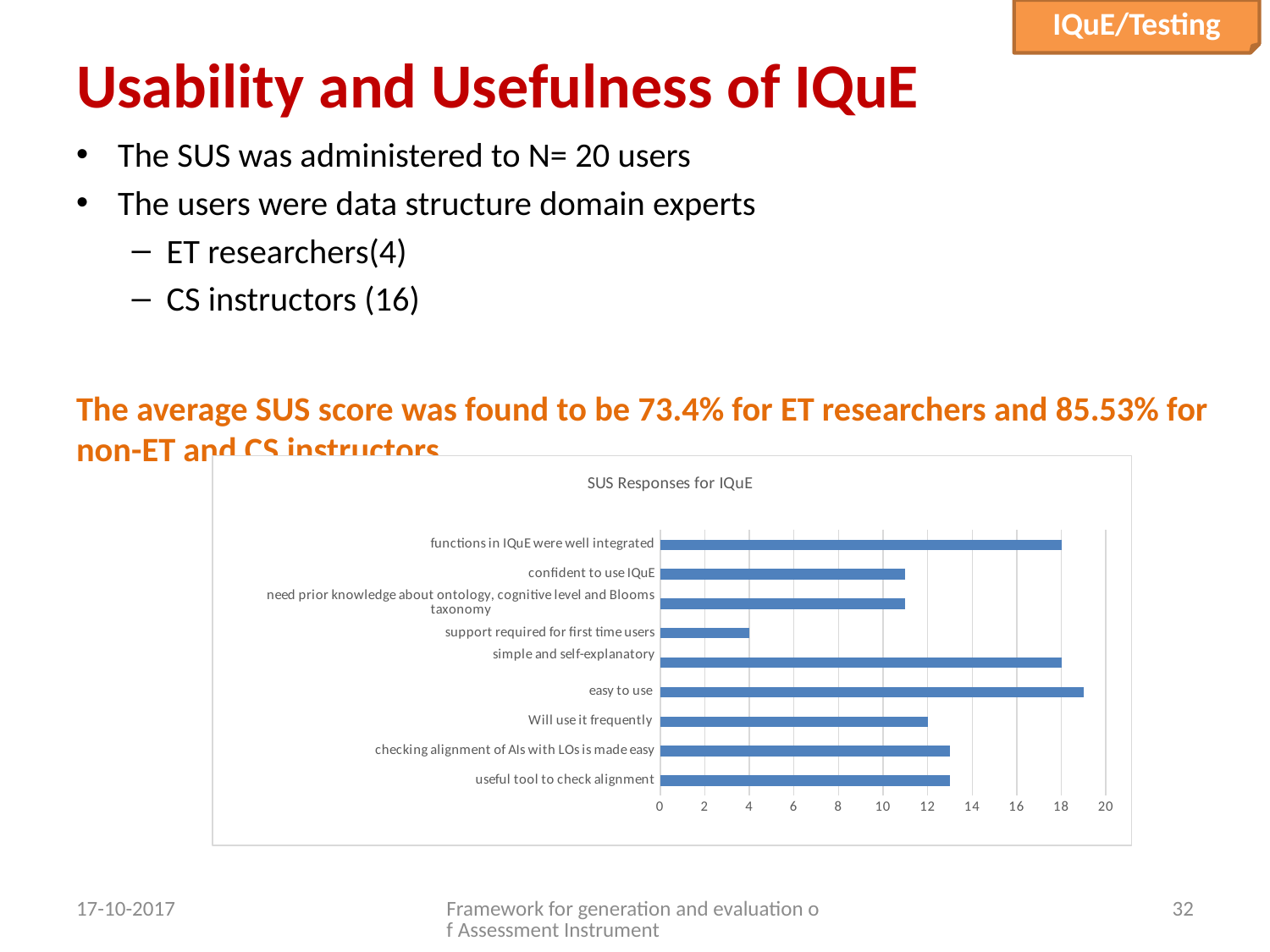
What is the value for 'Will use it frequently'? 12 Which is larger: the value for 'simple and self-explanatory' or the value for 'Will use it frequently'? simple and self-explanatory How many categories are plotted in the chart? 9 Which category has the lowest value in the chart? support required for first time users Is the value for 'confident to use IQuE' greater or less than 12? less Which category has the highest value in the chart? easy to use Is the value for 'useful tool to check alignment' greater or less than 12? greater What type of chart is shown on the slide? bar chart What is the value for 'support required for first time users'? 4 Is the value for 'easy to use' greater or less than 18? greater What is the title of the chart? SUS Responses for IQuE What is the highest value shown on the horizontal axis of the chart? 20